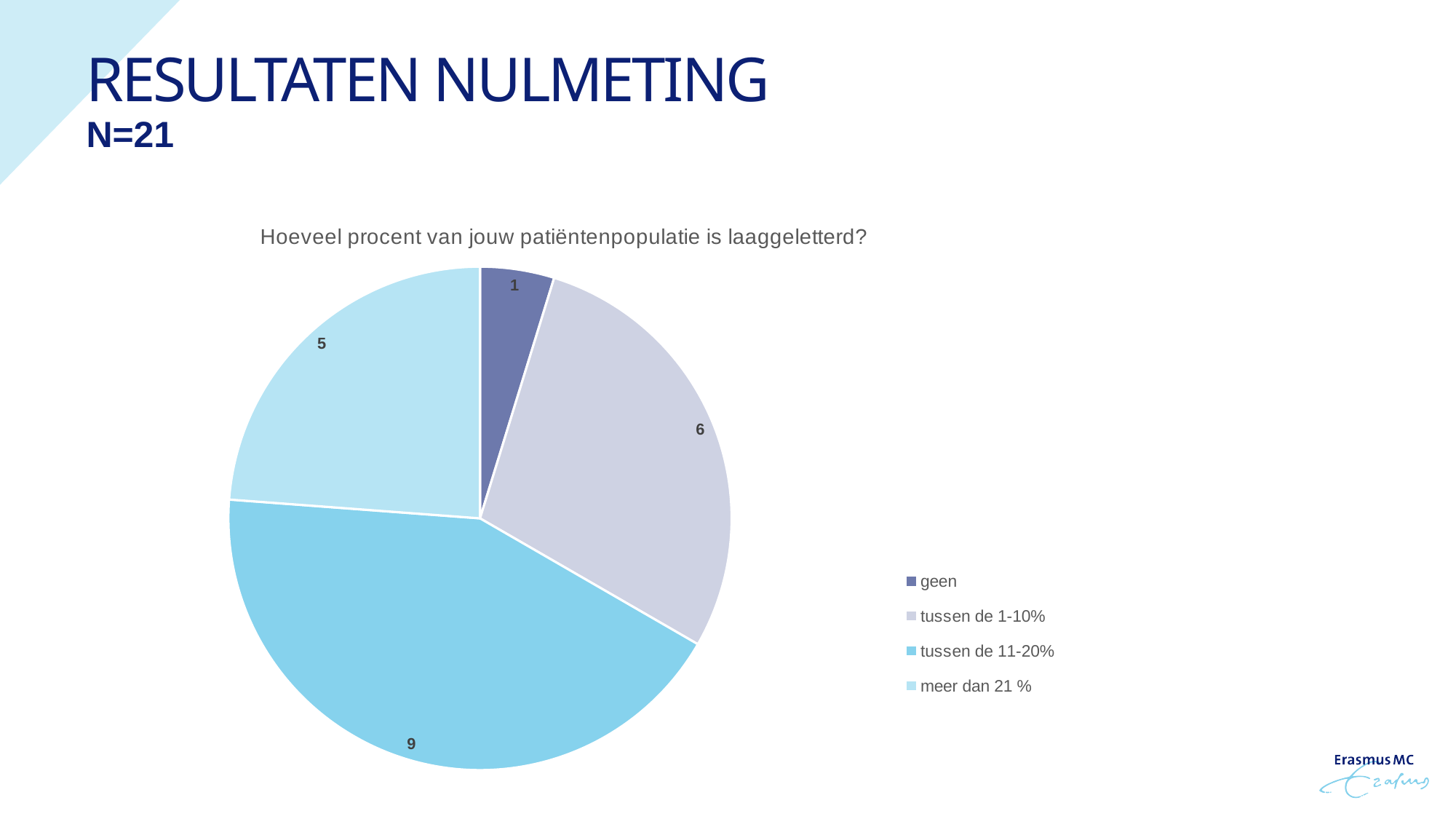
What is the title of the pie chart? Hoeveel procent van jouw patiëntenpopulatie is laaggeletterd? What is the value for the 'meer dan 21 %' slice? 5 What is the value for the 'tussen de 11-20%' slice? 9 What kind of chart is shown on the slide? pie chart Which category has the smallest slice of the pie? geen What is the value for the 'tussen de 1-10%' slice? 6 Which is larger, the value for 'tussen de 1-10%' or the value for 'meer dan 21 %'? tussen de 1-10% What is the value for the 'geen' slice? 1 How many slices does the pie chart have? 4 Which category has the largest slice of the pie? tussen de 11-20% What is the difference between the values for 'tussen de 11-20%' and 'tussen de 1-10%'? 3 What is the total of all the slice values in the pie chart? 21